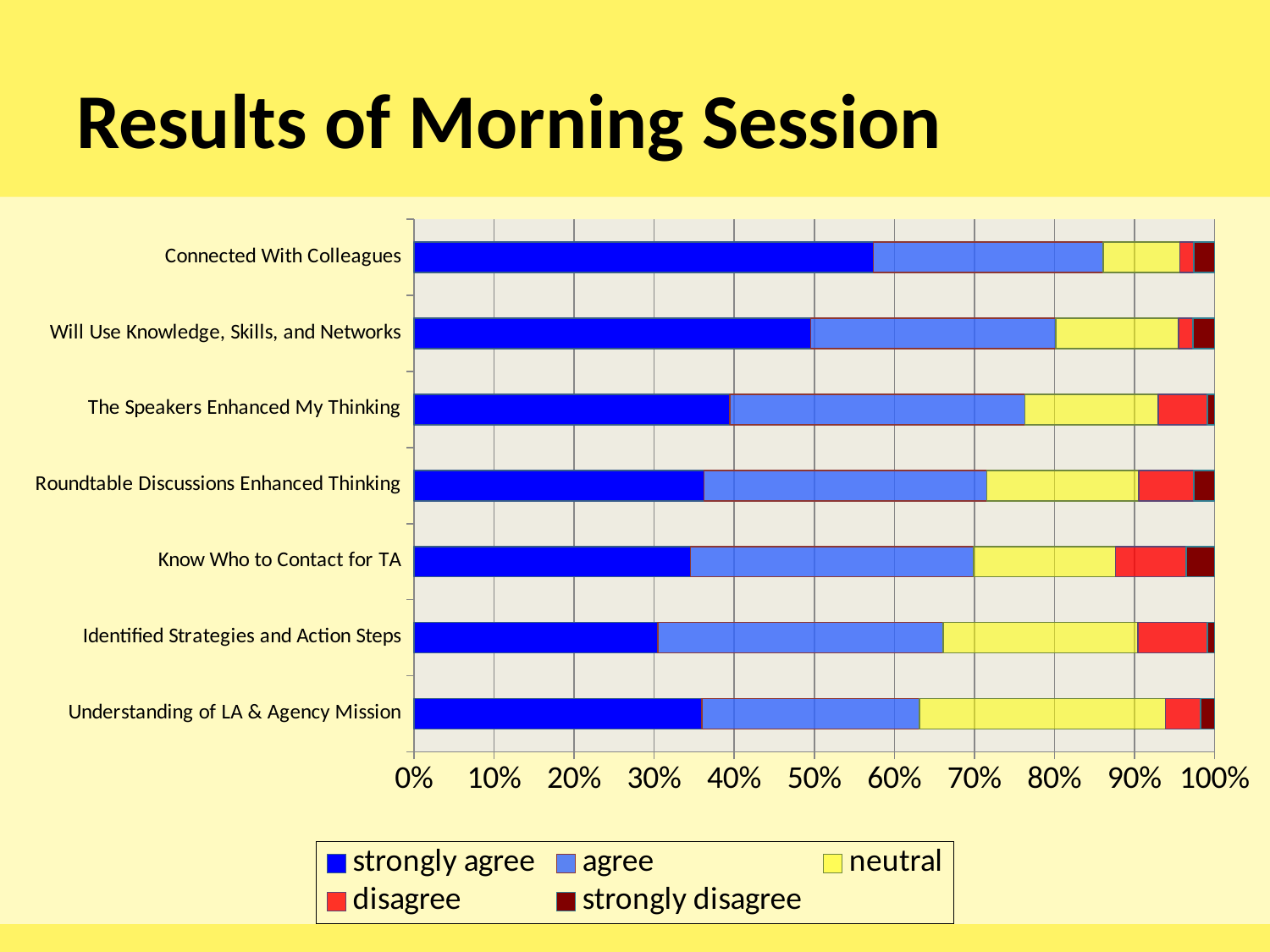
Is the 'strongly agree' share for The Speakers Enhanced My Thinking greater or less than 50%? less What is the title shown above the chart on the slide? Results of Morning Session Which has the larger 'strongly agree' share: Connected With Colleagues or The Speakers Enhanced My Thinking? Connected With Colleagues How many categories (statements) are plotted on the chart? 7 Is the 'strongly agree' share for Roundtable Discussions Enhanced Thinking greater or less than 40%? less What kind of chart is shown on the slide? stacked bar chart Is the 'strongly agree' share for Connected With Colleagues greater or less than 50%? greater Which category has the largest 'neutral' share? Understanding of LA & Agency Mission Which category has the largest 'strongly agree' share? Connected With Colleagues How many series does the legend list? 5 Which series is shown in dark blue according to the legend? strongly agree